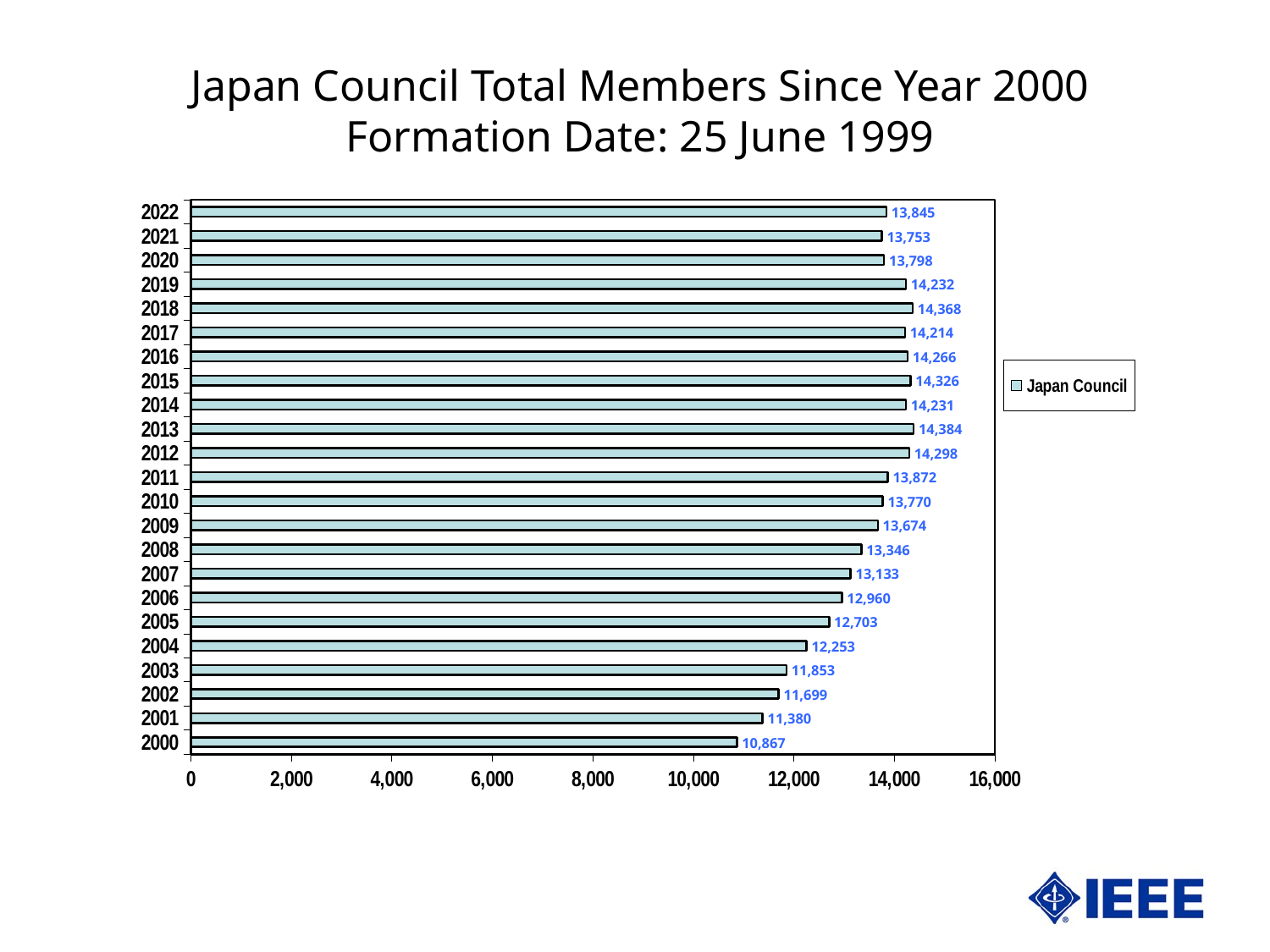
How many series does the legend list? 1 Is the membership value for 2003 greater or less than 12,000? less What is the Japan Council membership value for 2000? 10,867 Which year has the larger membership value, 2005 or 2010? 2010 How many years are shown in the chart? 23 What is the difference between the membership values for 2022 and 2000? 2,978 Which year has the lowest Japan Council membership? 2000 What kind of chart is shown on the slide? bar chart Which year has the highest Japan Council membership? 2013 What is the Japan Council membership value for 2013? 14,384 Do the membership values rise or fall from 2000 to 2008? rise What is the Japan Council membership value for 2022? 13,845